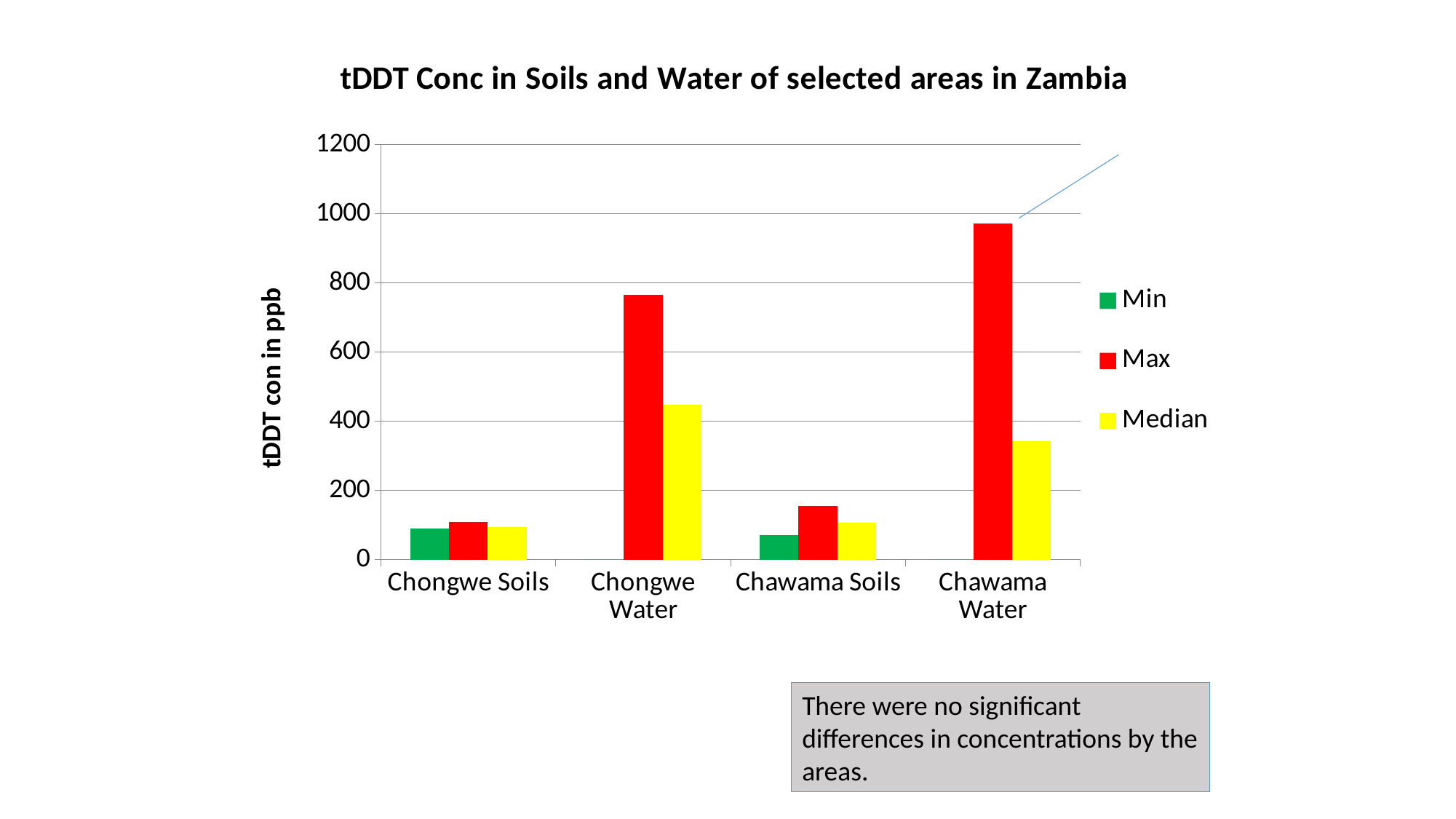
Which category has the lowest Max value? Chongwe Soils Is the Median value for Chawama Water greater or less than 400? less Which category has the highest Max value? Chawama Water What kind of chart is shown on the slide? bar chart Is the Max value for Chongwe Water greater or less than 600? greater Is the Max value for Chawama Soils greater or less than 200? less How many categories are shown on the x axis? 4 Which is larger, the Median value for Chongwe Water or the Median value for Chawama Water? Chongwe Water How many series does the legend list? 3 Which is larger, the Max value for Chongwe Soils or the Max value for Chawama Soils? Chawama Soils What is the title of the y axis? tDDT con in ppb